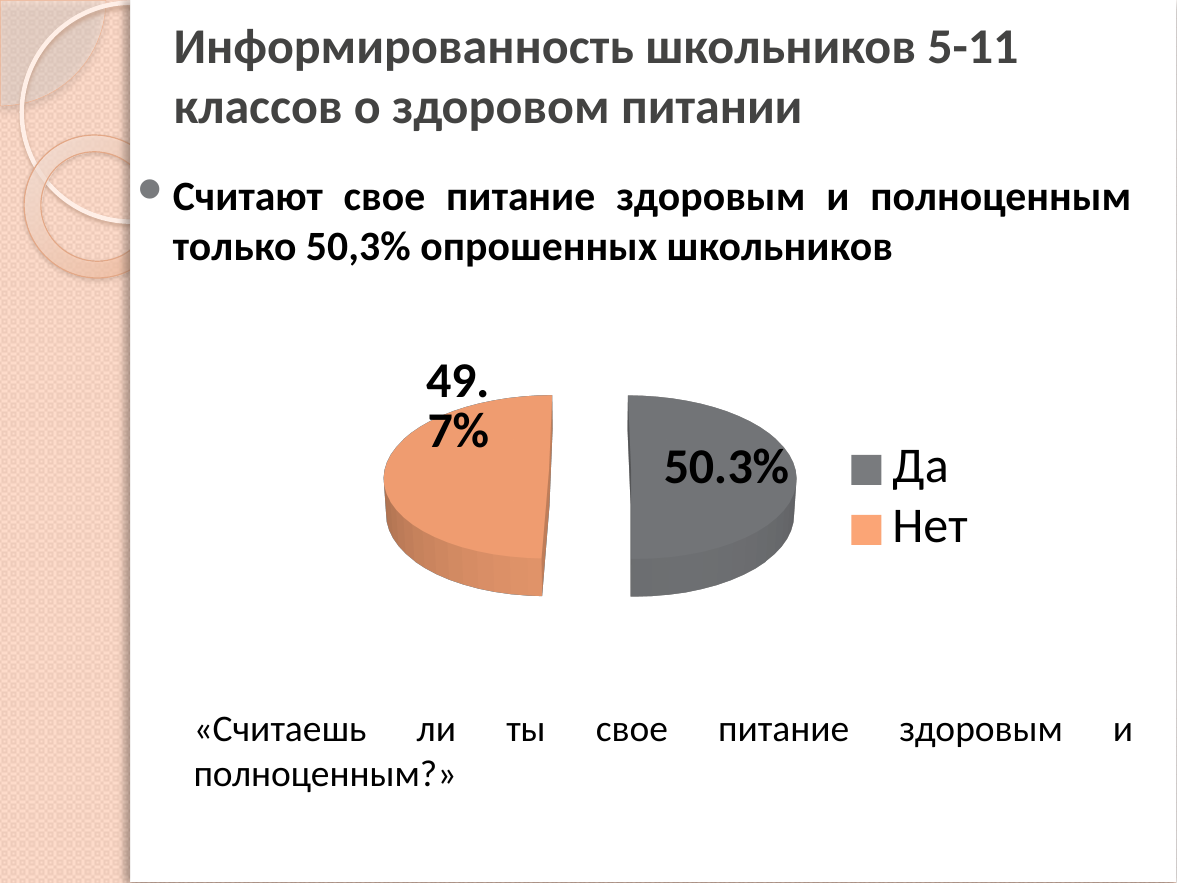
Is the share for "Да" greater or less than 50%? greater What type of chart is shown on the slide? Pie chart Which slice of the pie chart is larger, "Да" or "Нет"? Да What colour is the "Нет" slice in the pie chart? Orange What percentage of the pie chart is labelled "Нет"? 49.7% What colour is the "Да" slice in the pie chart? Gray How many entries does the chart legend list? 2 What percentage of the pie chart is labelled "Да"? 50.3% Which category has the largest share in the pie chart? Да What is the difference in percentage points between the "Да" and "Нет" slices? 0.6% Which category has the smallest share in the pie chart? Нет How many slices does the pie chart have? 2